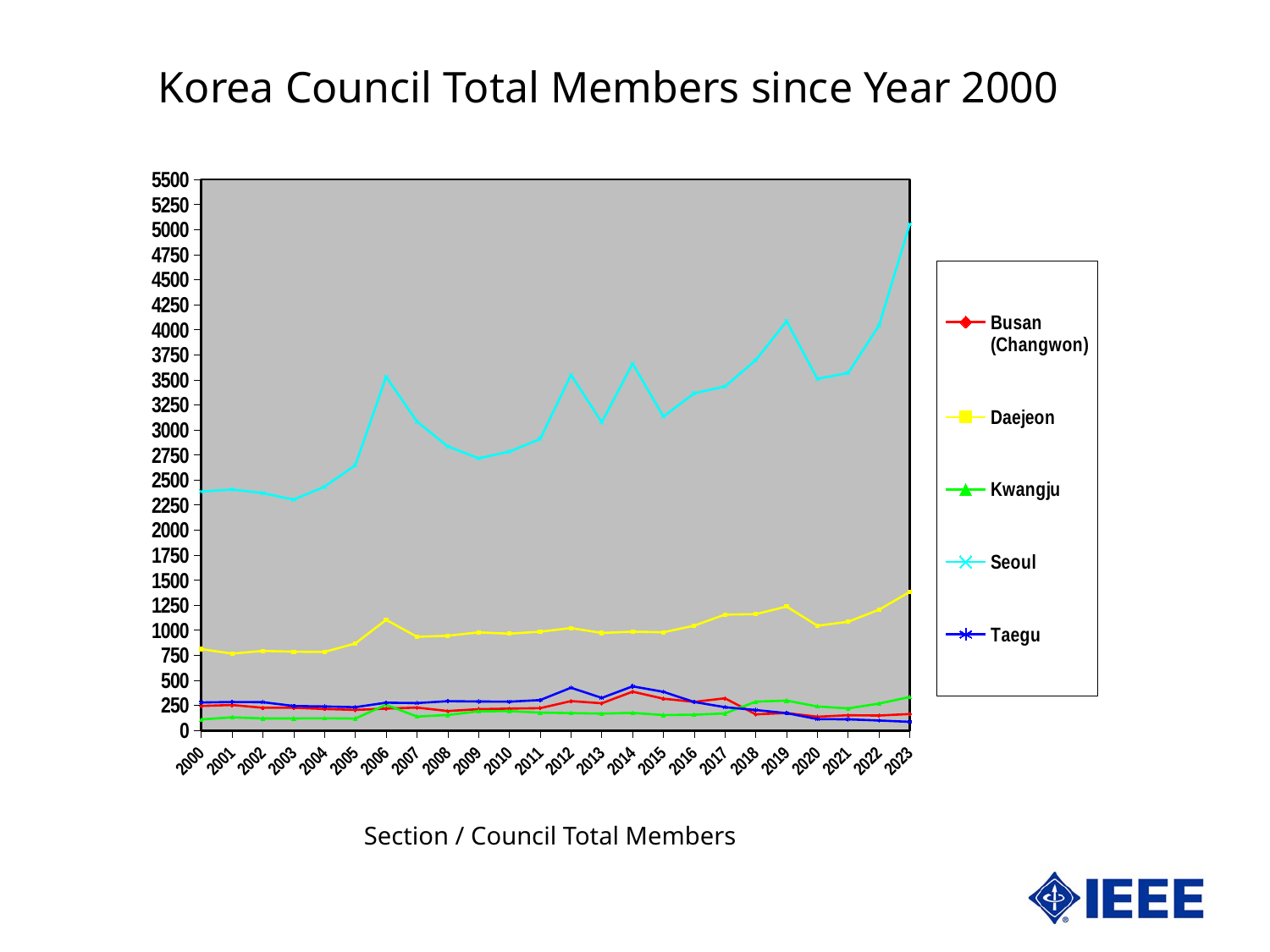
What kind of chart is shown on the slide? line chart Is the value for Seoul in 2023 greater or less than 4500? greater Which series has the highest membership across the whole period? Seoul Is the value for Daejeon in 2023 greater or less than 1250? greater How many years are plotted along the x axis? 24 Is the value for Taegu in 2023 greater or less than 250? less Which series has the lowest value in 2000? Kwangju In which year does the Seoul series reach its highest value? 2023 How many series does the legend list? 5 Does the Seoul series overall rise or fall from 2000 to 2023? rise Which is larger in 2010, Daejeon or Kwangju? Daejeon